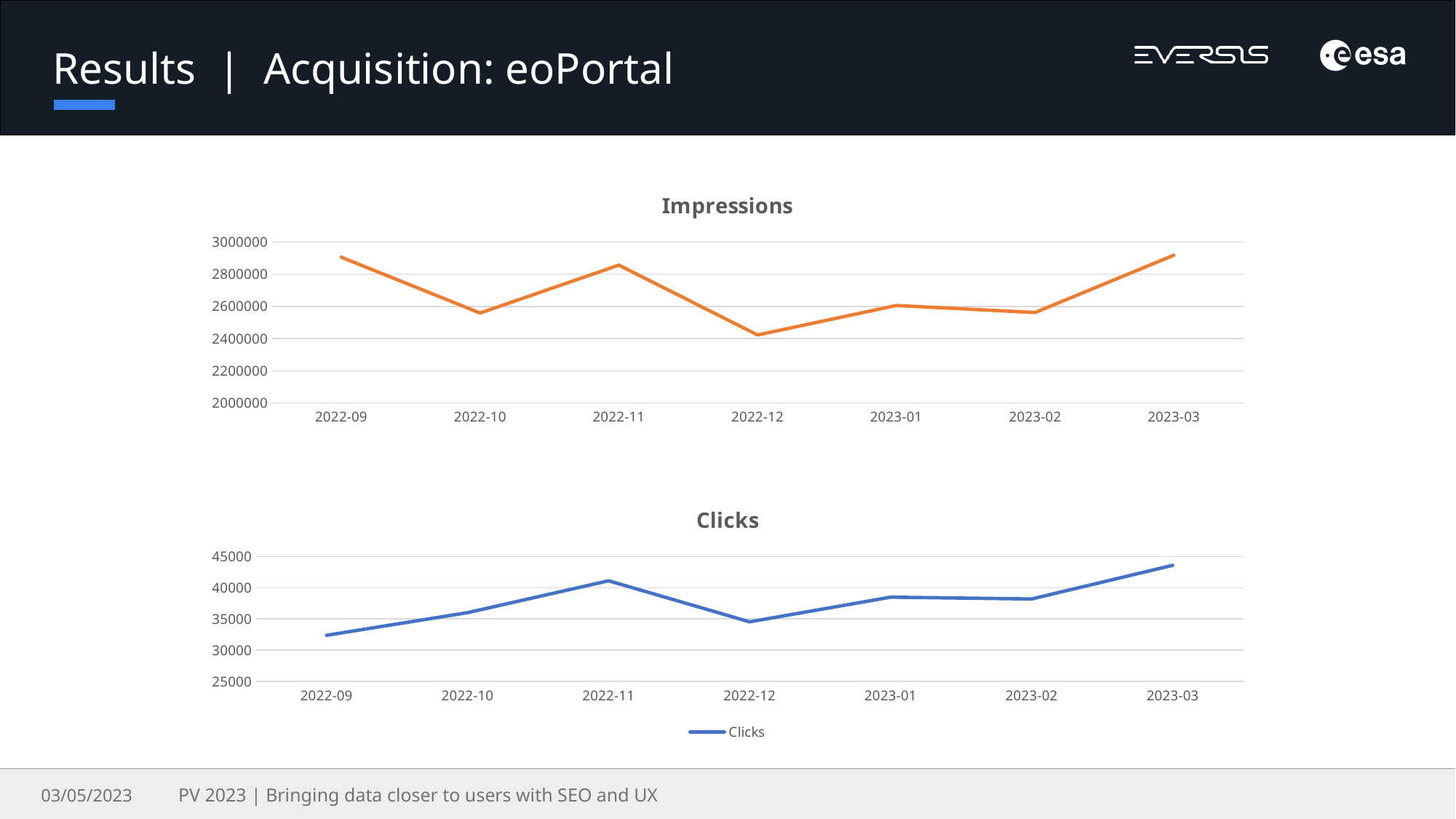
What kind of chart is the Impressions chart? line chart How many months are plotted in the Clicks chart? 7 In the Clicks chart, is the value for 2022-09 greater or less than 35000? less How many series does the legend of the Clicks chart list? 1 In the Impressions chart, which month has the larger value, 2022-11 or 2022-12? 2022-11 In the Clicks chart, is the value for 2023-03 greater or less than 40000? greater In the Impressions chart, is the value for 2022-09 greater or less than 2800000? greater In the Impressions chart, which month has the lowest value? 2022-12 In the Clicks chart, which month has the highest value? 2023-03 In the Clicks chart, which month has the lowest value? 2022-09 In the Clicks chart, which month has the larger value, 2022-12 or 2023-01? 2023-01